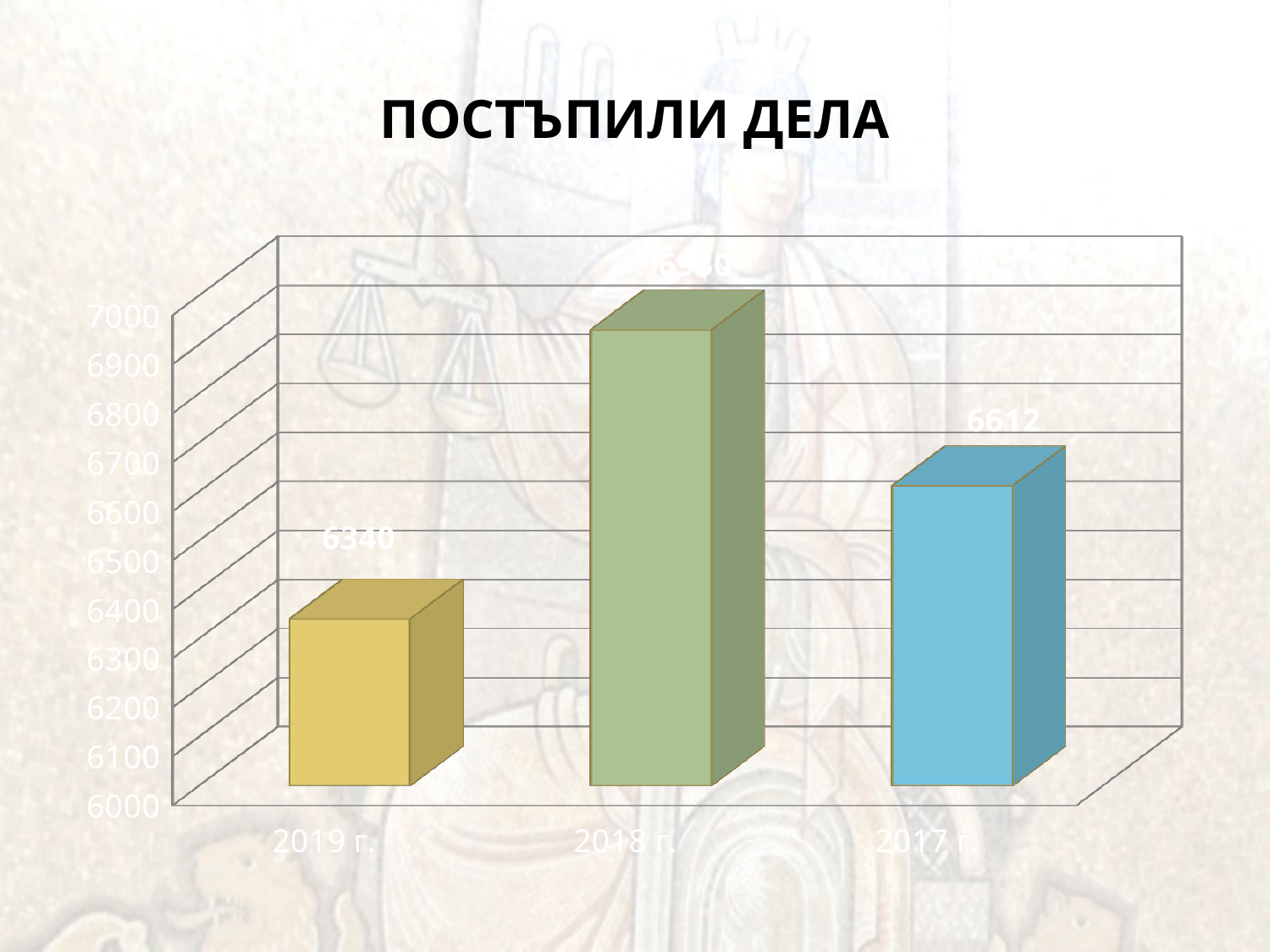
How many categories are shown on the x axis? 3 Which year has the lowest value? 2019 г. What kind of chart is shown on the slide? bar chart Is the value for 2019 г. greater or less than 6400? less Is the value for 2018 г. greater or less than 6900? greater Does the value rise or fall from 2019 г. to 2018 г.? rise What is the title of the chart? ПОСТЪПИЛИ ДЕЛА What is the difference between the values for 2017 г. and 2019 г.? 272 What is the value for 2017 г.? 6612 Which is larger, the value for 2017 г. or the value for 2019 г.? 2017 г. What is the value for 2019 г.? 6340 Which year has the highest value? 2018 г.